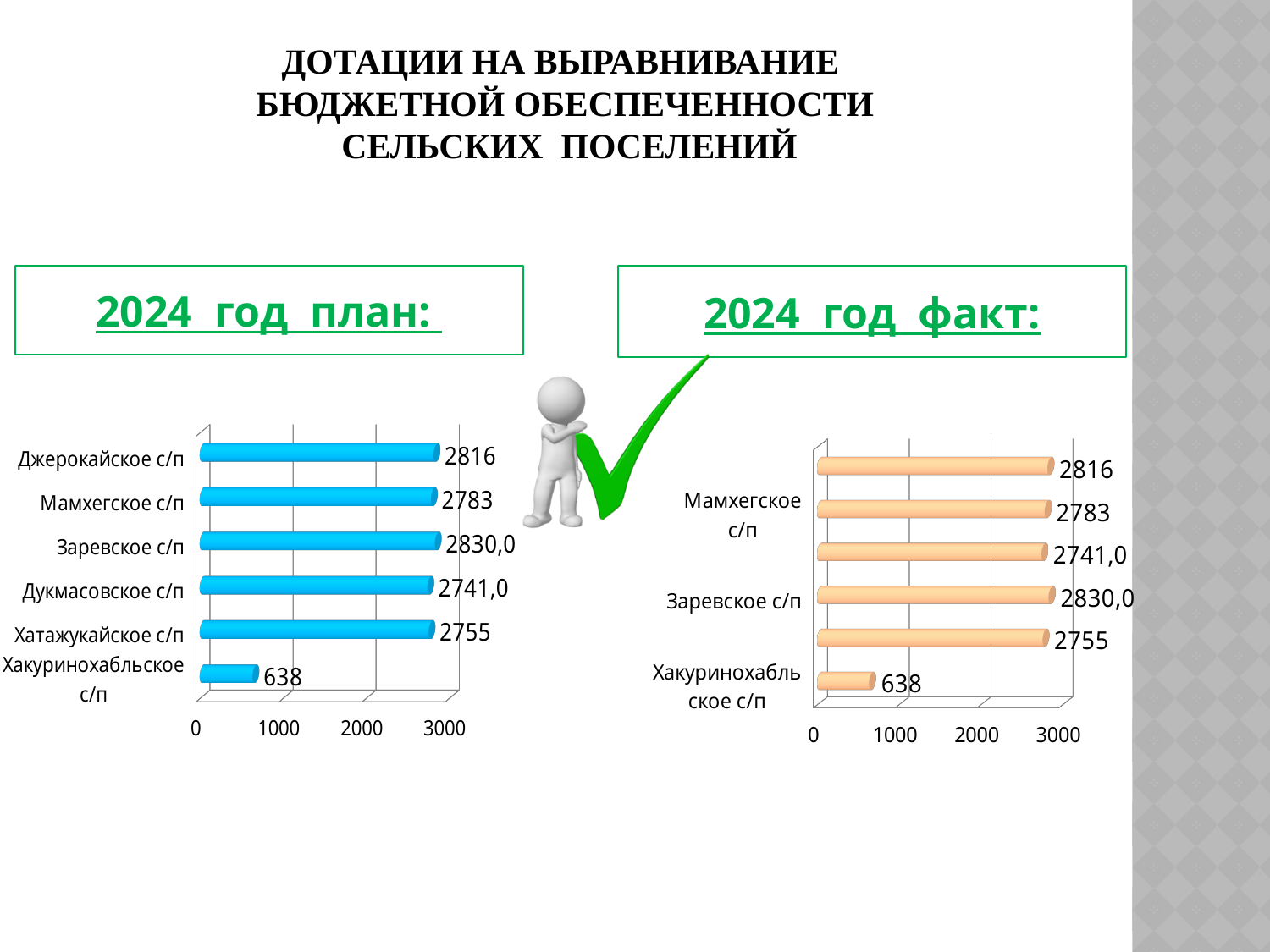
In the '2024 год факт' chart, what is the value for Хакуринохабльское с/п? 638 In the '2024 год план' chart, is the value for Хакуринохабльское с/п greater or less than 1000? less In the '2024 год план' chart, what is the value for Джерокайское с/п? 2816 In the '2024 год план' chart, what is the difference between the values for Джерокайское с/п and Мамхегское с/п? 33 In the '2024 год факт' chart, what is the value for Заревское с/п? 2830,0 In the '2024 год план' chart, which category has the lowest value? Хакуринохабльское с/п How many categories are shown in the '2024 год план' chart? 6 In the '2024 год план' chart, what is the value for Дукмасовское с/п? 2741,0 In the '2024 год план' chart, which category has the highest value? Заревское с/п In the '2024 год план' chart, which is larger: the value for Хатажукайское с/п or Дукмасовское с/п? Хатажукайское с/п What colour are the bars in the '2024 год план' chart? blue What kind of chart is the '2024 год факт' chart? bar chart